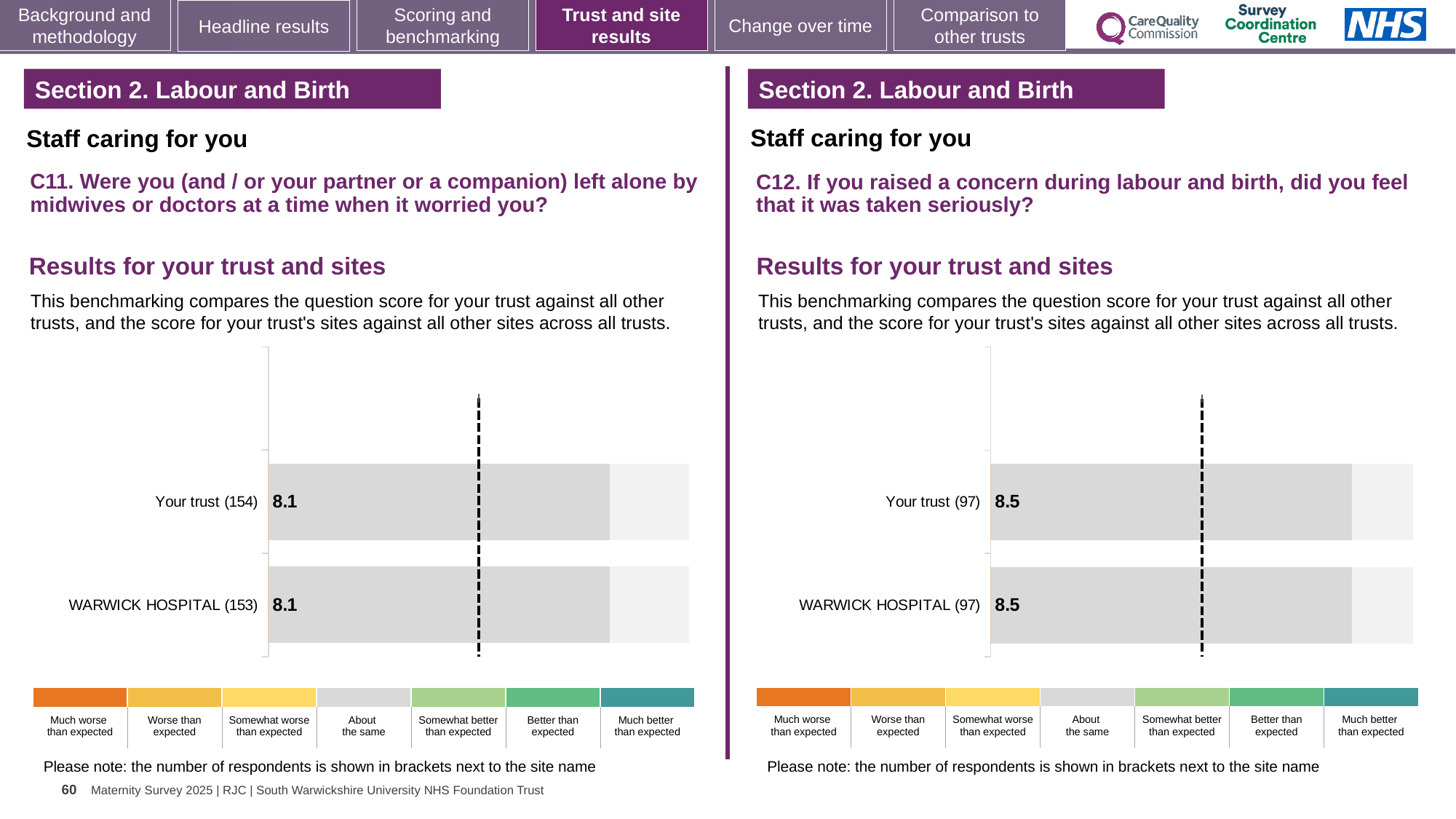
How many bars are plotted on the C11 chart (left)? 2 How many bars are plotted on the C12 chart (right)? 2 On the C11 chart (left), which benchmark category does the grey colour of the bars correspond to in the legend? About the same On the C11 chart (left), what is the difference between the Your trust score and the WARWICK HOSPITAL score? 0.0 On the C11 chart (left), what is the score for Your trust? 8.1 On the C12 chart (right), what is the score for WARWICK HOSPITAL? 8.5 On the C12 chart (right), what is the difference between the Your trust score and the WARWICK HOSPITAL score? 0.0 On the C11 chart (left), what is the score for WARWICK HOSPITAL? 8.1 On the C11 chart (left), how many respondents are shown in brackets for Your trust? 154 On the C12 chart (right), how many respondents are shown in brackets for WARWICK HOSPITAL? 97 What kind of chart is used on the C12 chart (right)? Bar chart On the C12 chart (right), what is the score for Your trust? 8.5